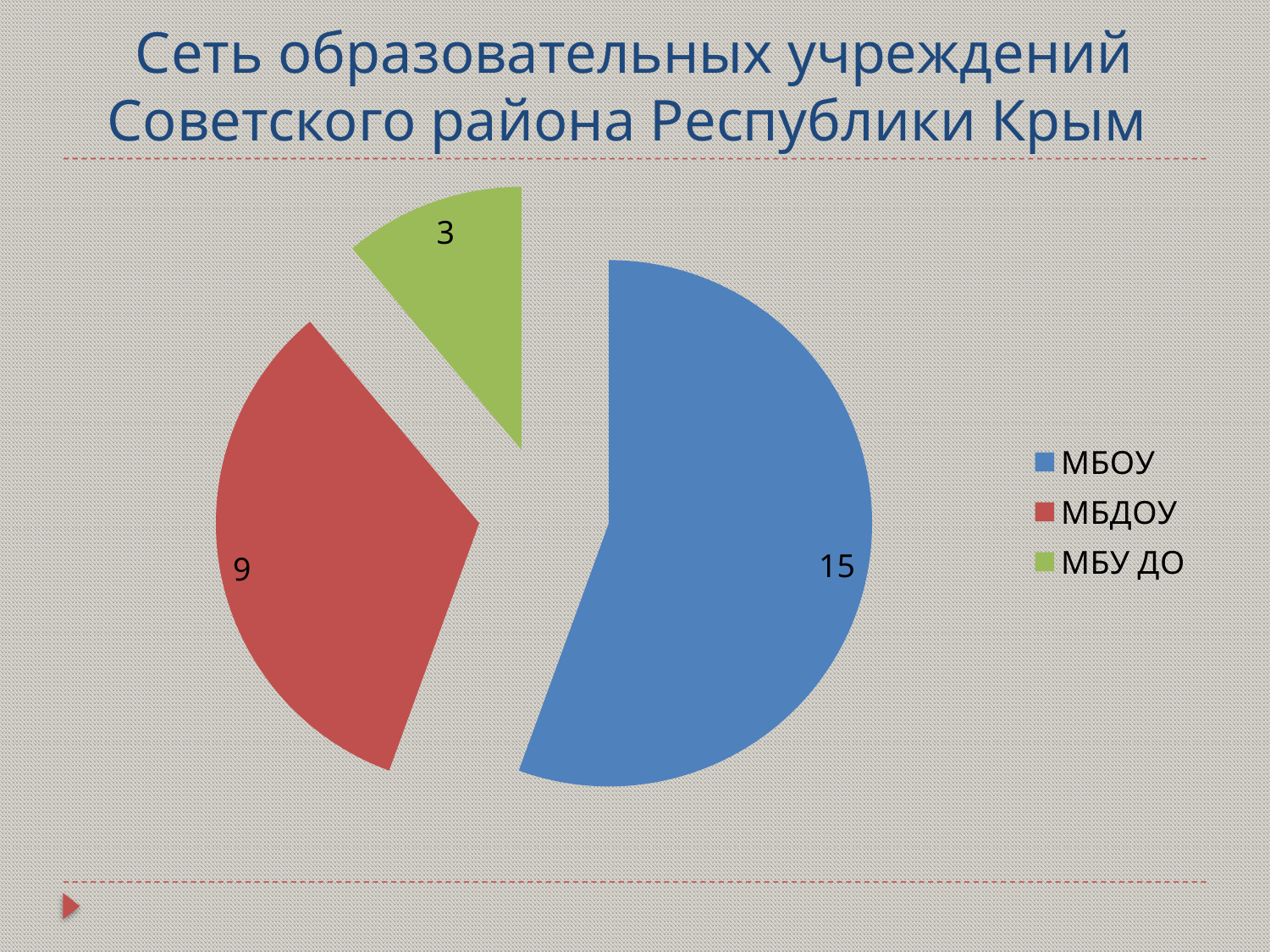
What type of chart is shown on the slide? pie chart What is the difference between the values for МБОУ and МБДОУ? 6 Which category has the smallest slice? МБУ ДО What is the value for МБОУ? 15 Which is larger, the value for МБДОУ or the value for МБУ ДО? МБДОУ What is the value for МБДОУ? 9 How many categories does the pie chart have? 3 What colour is the slice for МБУ ДО? green What is the value for МБУ ДО? 3 What is the title of the slide? Сеть образовательных учреждений Советского района Республики Крым Which category has the largest slice? МБОУ What is the total of all slices in the pie chart? 27